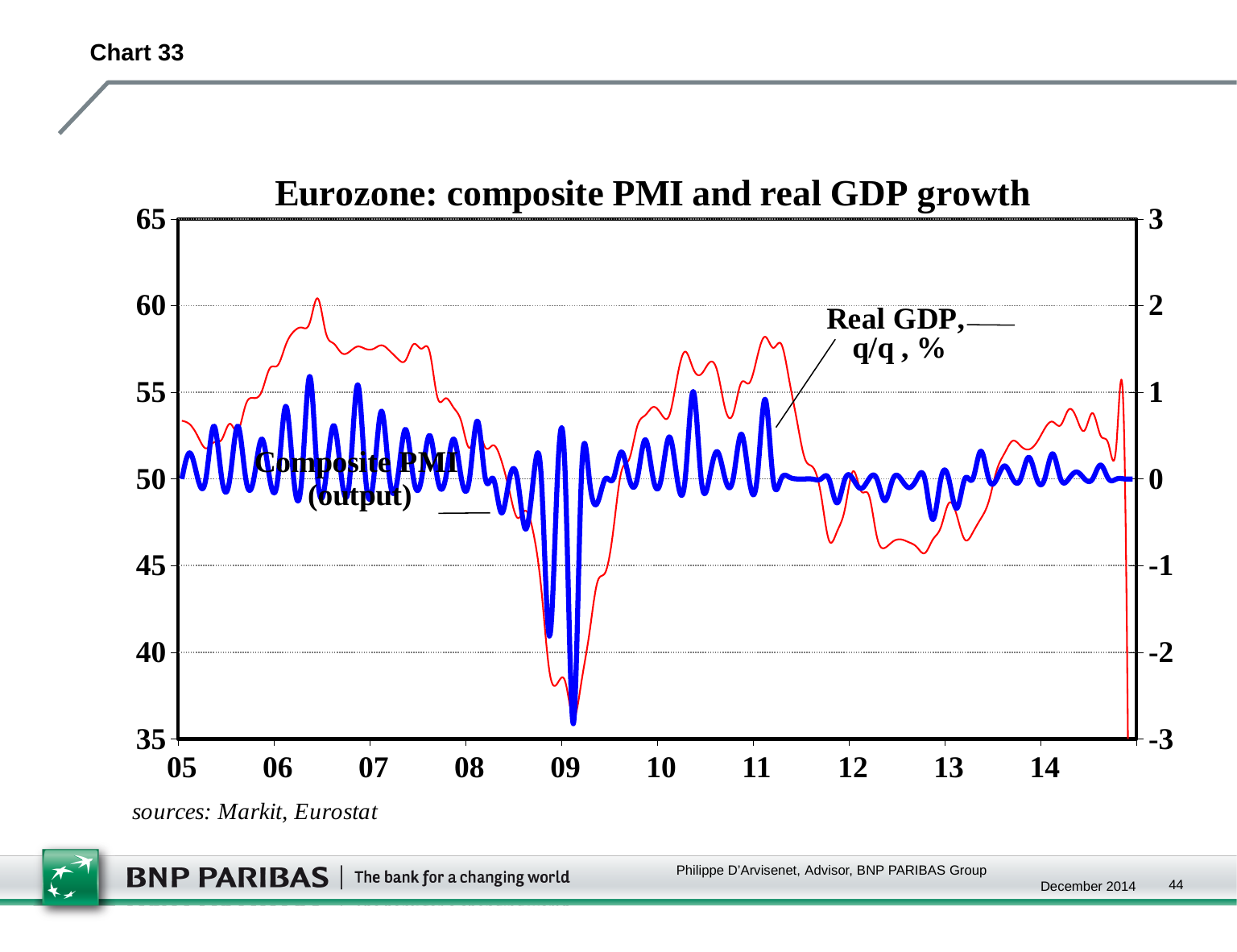
In which year does the Composite PMI (output) line reach its lowest point? 09 What kind of chart is shown on the slide? line chart Is the Composite PMI (output) value at the start of 2007 greater or less than 55? greater How many year labels are shown on the x axis? 10 Which series is drawn in blue? Real GDP, q/q, % Is the lowest value of the Composite PMI (output) line in 2009 greater or less than 40? less Does the Composite PMI (output) line rise or fall between 2011 and 2012? fall How many series are plotted on the chart? 2 In which year does the Real GDP, q/q, % line reach its lowest point? 09 Is the Composite PMI (output) value in the middle of 2012 greater or less than 50? less What is the title of the chart? Eurozone: composite PMI and real GDP growth